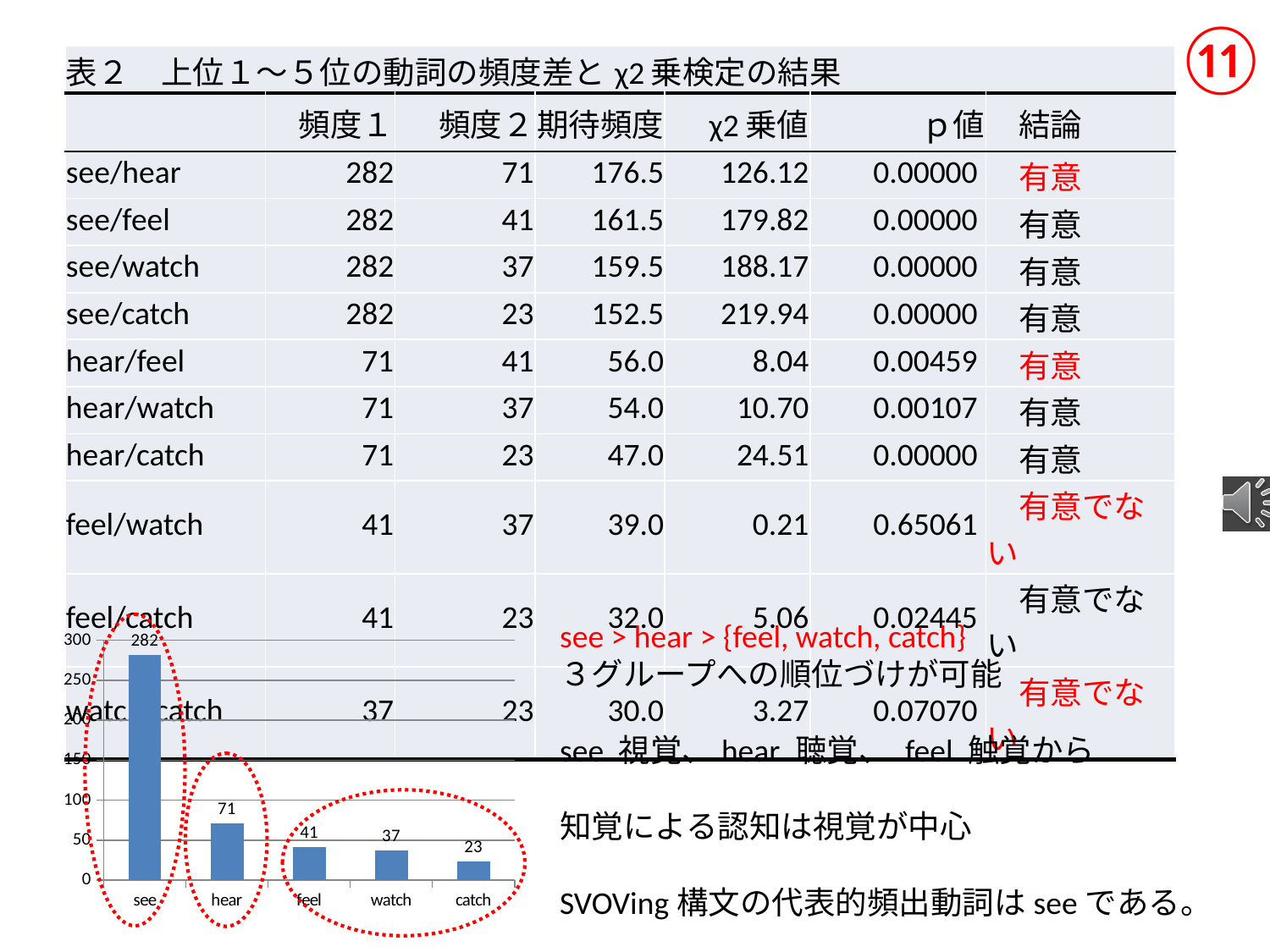
What is the difference between the values for see and hear in the bar chart? 211 Which category has the highest bar in the chart? see What is the difference between the values for feel and catch in the bar chart? 18 Is the value for see in the bar chart greater or less than 250? greater What is the value for watch in the bar chart? 37 What kind of chart is shown at the bottom left of the slide? bar chart Which is larger in the bar chart, the value for hear or the value for feel? hear What is the value for catch in the bar chart? 23 What is the value for see in the bar chart? 282 Which category has the lowest bar in the chart? catch What is the value for hear in the bar chart? 71 How many categories are shown on the x axis of the bar chart? 5